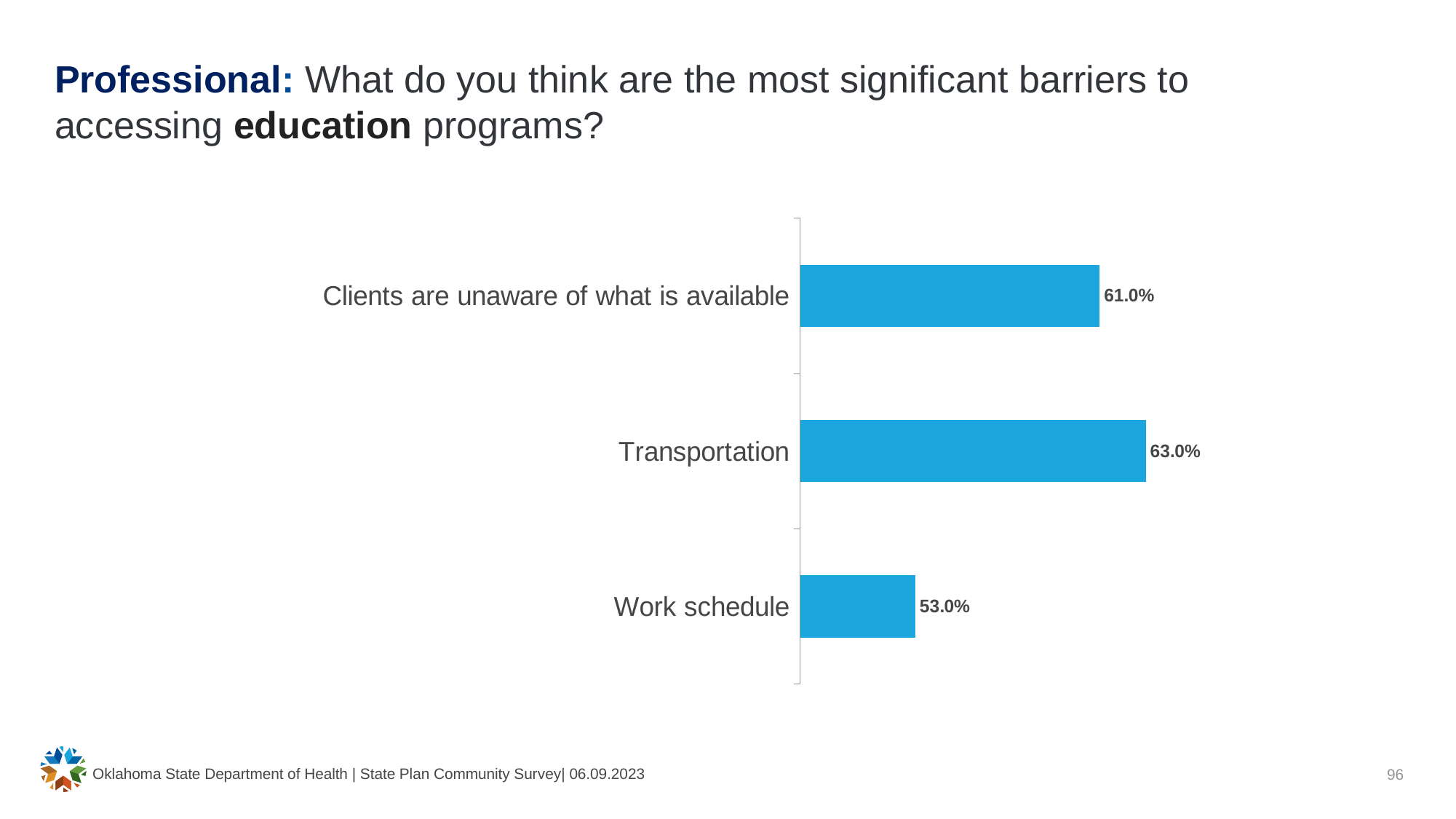
What colour are the bars in the chart? Blue What kind of chart is shown on the slide? Bar chart What is the value for Clients are unaware of what is available? 61.0% Which is larger, the value for Clients are unaware of what is available or the value for Work schedule? Clients are unaware of what is available Which barrier has the highest value? Transportation Which group of respondents does the slide title say the question was asked of? Professional How many barriers are shown in the chart? 3 Which barrier has the lowest value? Work schedule What is the difference between the values for Transportation and Clients are unaware of what is available? 2.0% What is the value for Transportation? 63.0% What is the value for Work schedule? 53.0% What is the difference between the values for Transportation and Work schedule? 10.0%